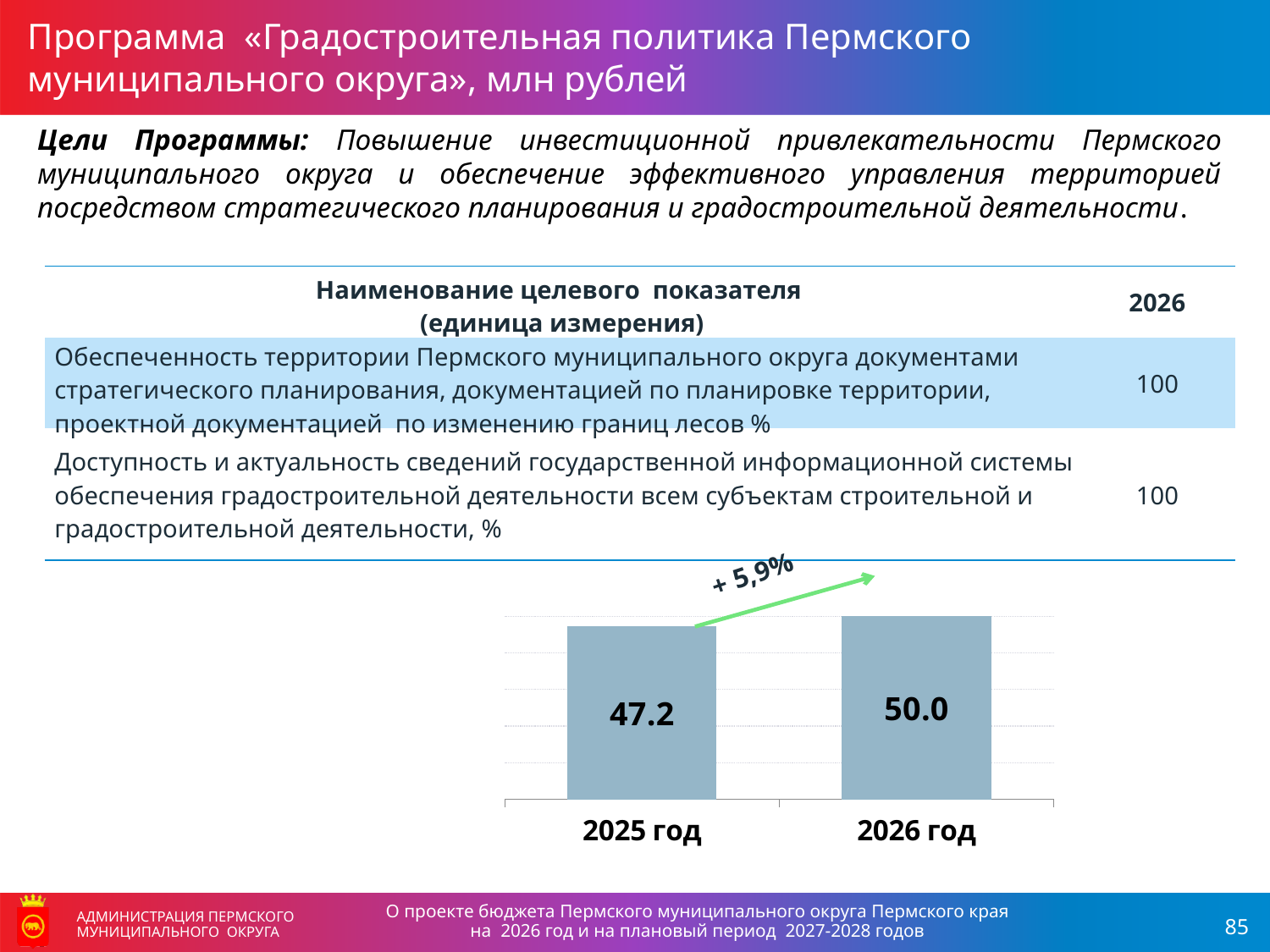
What is the difference between the values for 2026 год and 2025 год? 2.8 How many bars are plotted on the chart? 2 Which year has the lower value on the chart? 2025 год What percentage change is annotated above the bars on the chart? + 5,9% Is the value for 2026 год larger or smaller than the value for 2025 год? larger What is the value shown for 2026 год? 50.0 Which year has the higher value on the chart? 2026 год In what units are the values on the chart expressed, according to the slide title? млн рублей Do the values rise or fall from 2025 год to 2026 год? rise What kind of chart is shown on the slide? bar chart What is the value shown for 2025 год? 47.2